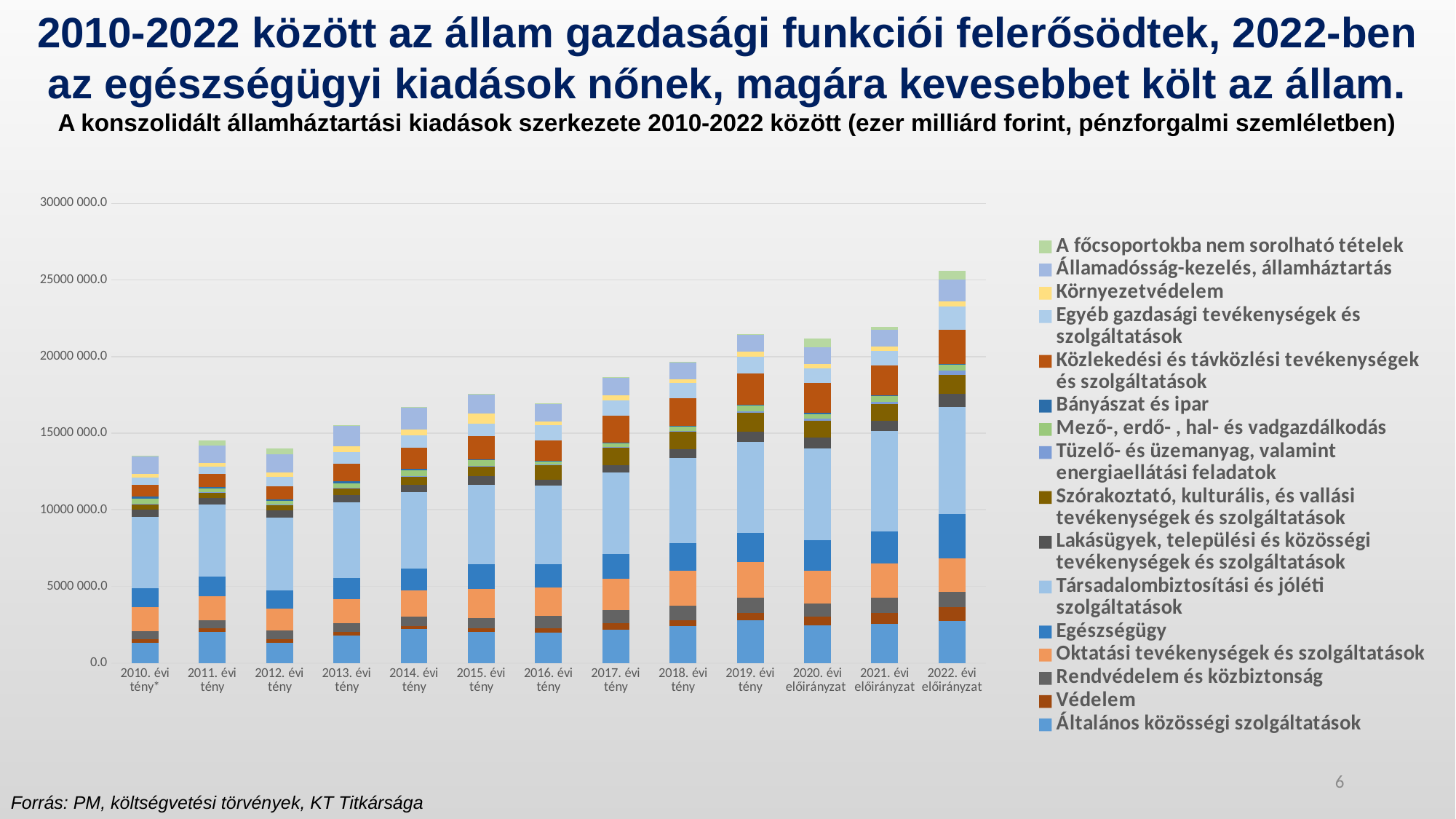
Is the total of the 2022. évi előirányzat bar greater or less than 20000 000.0? greater Which series is shown at the bottom of each stacked bar, according to the legend? Általános közösségi szolgáltatások Do the total stacked bar heights generally rise or fall from 2010 to 2022? Rise How many years (bars) are plotted on the x axis of the chart? 13 What kind of chart is shown on the slide? Stacked bar chart Which year has the tallest stacked bar (highest total expenditure)? 2022. évi előirányzat Which bar is taller: 2021. évi előirányzat or 2016. évi tény? 2021. évi előirányzat Which year has the shortest stacked bar (lowest total expenditure)? 2010. évi tény* How many series does the chart's legend list? 16 Is the total of the 2017. évi tény bar greater or less than 20000 000.0? less Is the total of the 2010. évi tény* bar greater or less than 15000 000.0? less